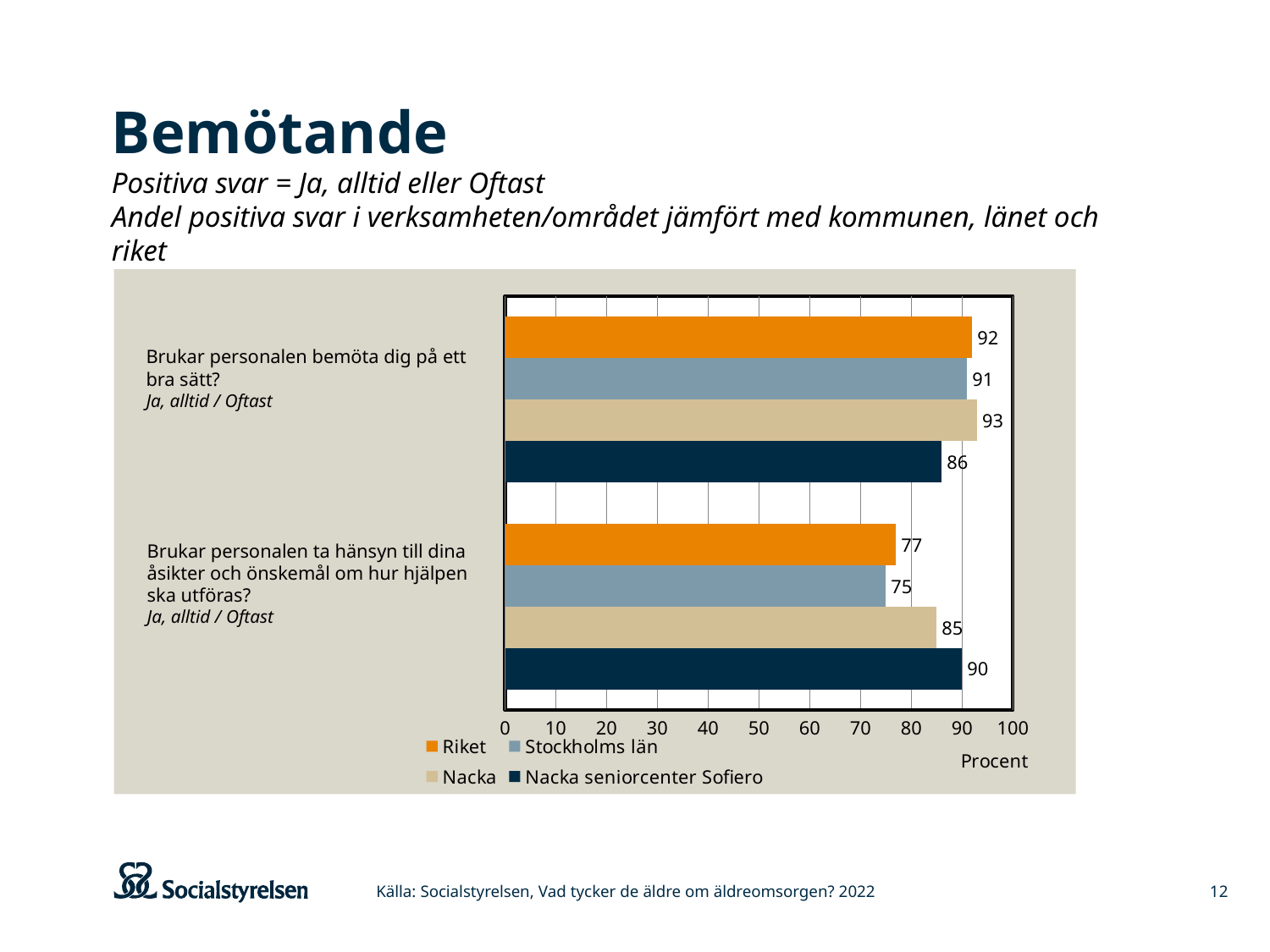
How many questions (categories) are shown on the chart? 2 What is the difference between Nacka seniorcenter Sofiero and Riket on the question "Brukar personalen ta hänsyn till dina åsikter och önskemål om hur hjälpen ska utföras?"? 13 How many series does the legend list? 4 Which series has the lowest value on the question "Brukar personalen ta hänsyn till dina åsikter och önskemål om hur hjälpen ska utföras?"? Stockholms län What is the value for Nacka seniorcenter Sofiero on the question "Brukar personalen ta hänsyn till dina åsikter och önskemål om hur hjälpen ska utföras?"? 90 What is the label of the x axis? Procent Which series is shown in orange in the legend? Riket Which is larger on the question "Brukar personalen bemöta dig på ett bra sätt?": Nacka or Nacka seniorcenter Sofiero? Nacka What is the value for Stockholms län on the question "Brukar personalen ta hänsyn till dina åsikter och önskemål om hur hjälpen ska utföras?"? 75 What is the value for Riket on the question "Brukar personalen bemöta dig på ett bra sätt?"? 92 What kind of chart is shown on the slide? Bar chart Which series has the highest value on the question "Brukar personalen bemöta dig på ett bra sätt?"? Nacka